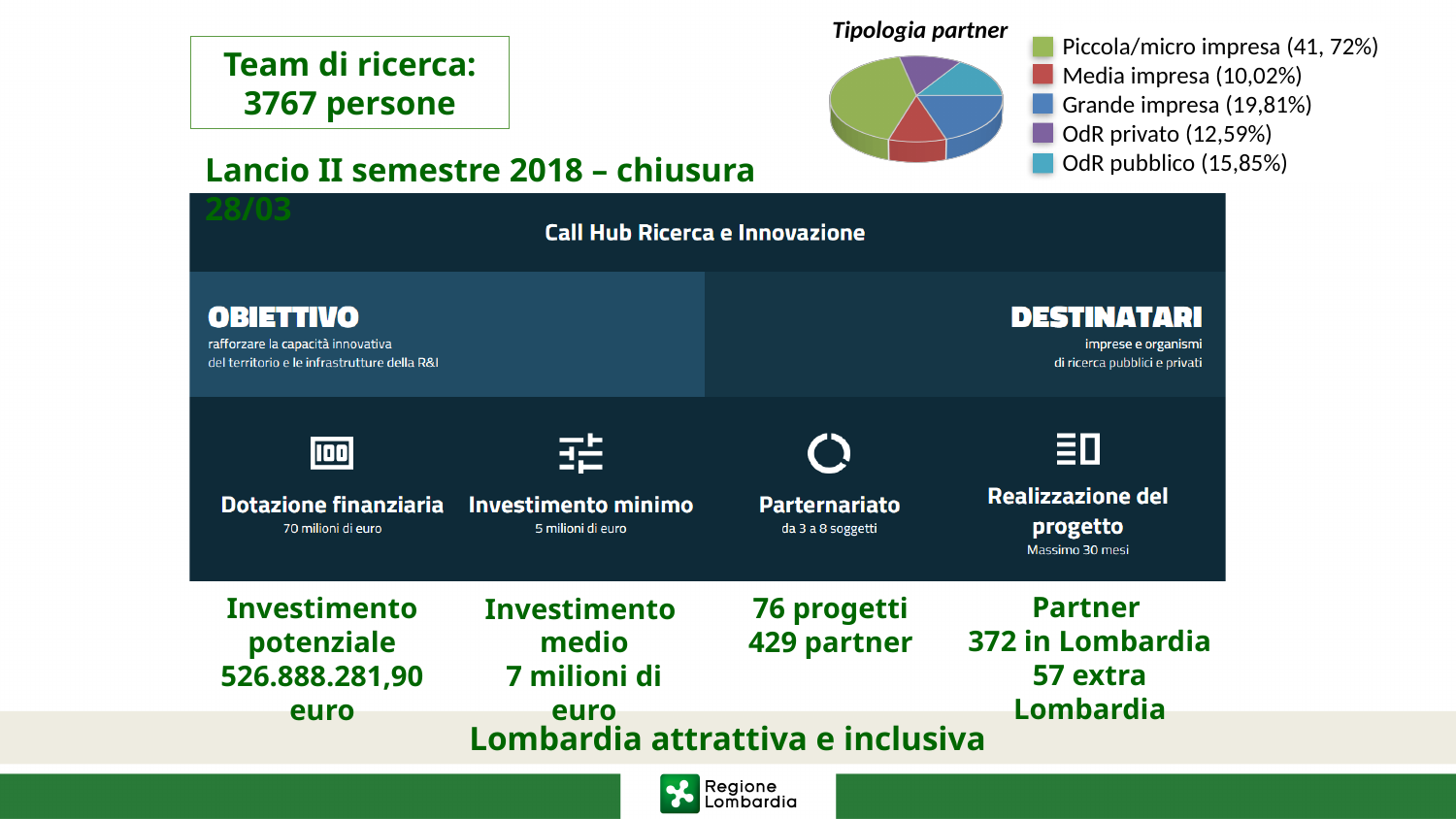
In the 'Tipologia partner' chart, which partner type has the largest share? Piccola/micro impresa In the 'Tipologia partner' chart, which partner type has the smallest share? Media impresa In the 'Tipologia partner' chart, what percentage is shown for OdR pubblico? 15,85% In the 'Tipologia partner' chart, what is the difference in percentage points between OdR pubblico and OdR privato? 3,26 In the 'Tipologia partner' chart, which has a larger share: Grande impresa or OdR pubblico? Grande impresa In the 'Tipologia partner' chart, what percentage is shown for Media impresa? 10,02% In the 'Tipologia partner' chart, what percentage is shown for Grande impresa? 19,81% What is the title of the pie chart on the slide? Tipologia partner What kind of chart is the 'Tipologia partner' chart? pie chart In the 'Tipologia partner' chart, what percentage is shown for OdR privato? 12,59% How many partner types are shown in the 'Tipologia partner' chart? 5 In the 'Tipologia partner' chart, what is the difference in percentage points between Grande impresa and OdR pubblico? 3,96